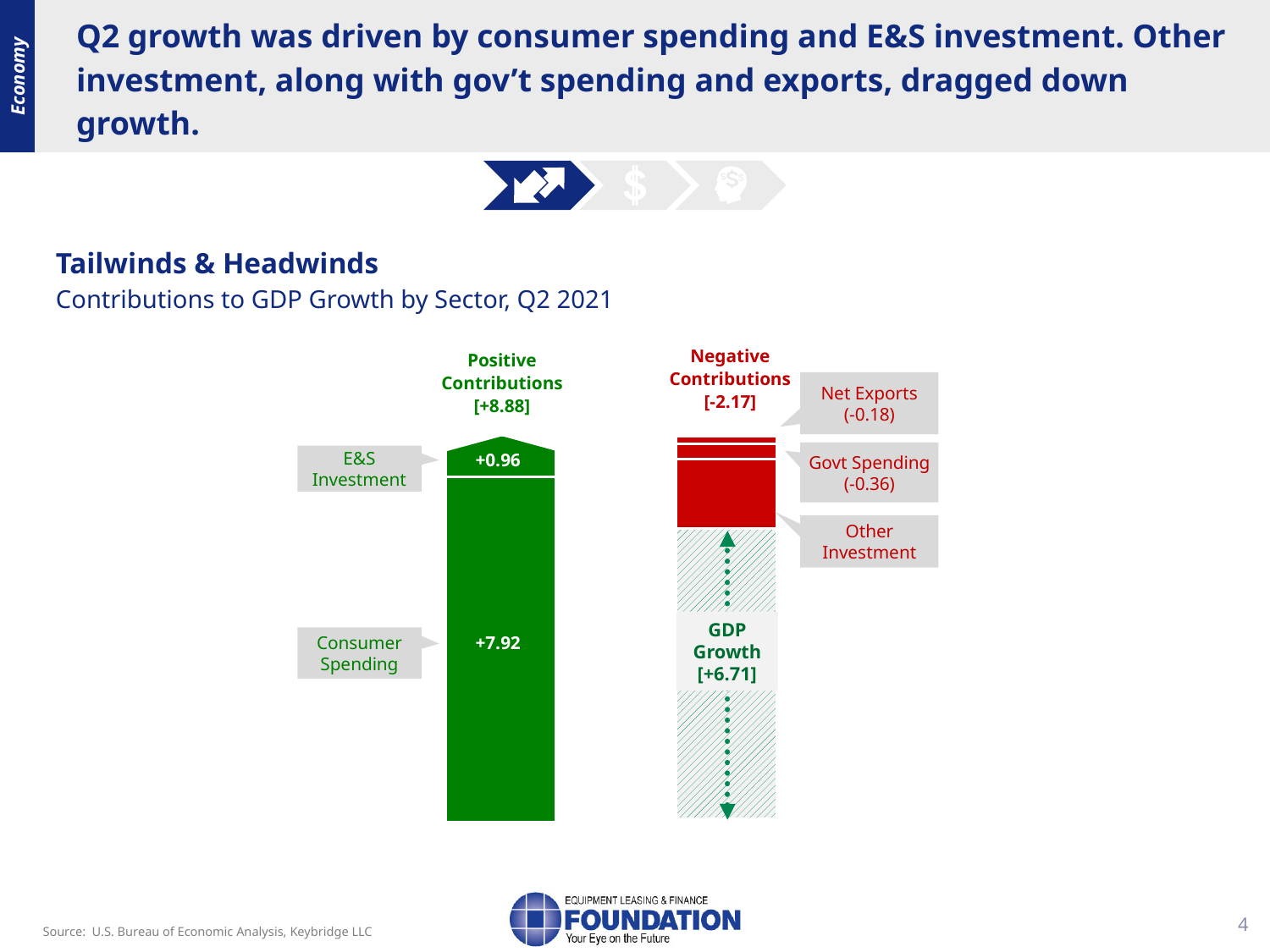
What is the GDP Growth figure shown on the chart? +6.71 What is the total of the Negative Contributions bar? -2.17 What is the total of the Positive Contributions bar? +8.88 Which sector made the largest positive contribution to GDP growth? Consumer Spending What is the contribution of Net Exports shown on the chart? -0.18 What is the contribution of Govt Spending shown on the chart? -0.36 Which of the labelled negative contributions is larger in magnitude, Net Exports or Govt Spending? Govt Spending What is the difference between the Consumer Spending contribution and the E&S Investment contribution? 6.96 What is the contribution of E&S Investment to GDP growth shown on the chart? +0.96 What kind of chart is shown on the slide? Bar chart What is the subtitle of the chart below 'Tailwinds & Headwinds'? Contributions to GDP Growth by Sector, Q2 2021 What is the contribution of Consumer Spending to GDP growth shown on the chart? +7.92